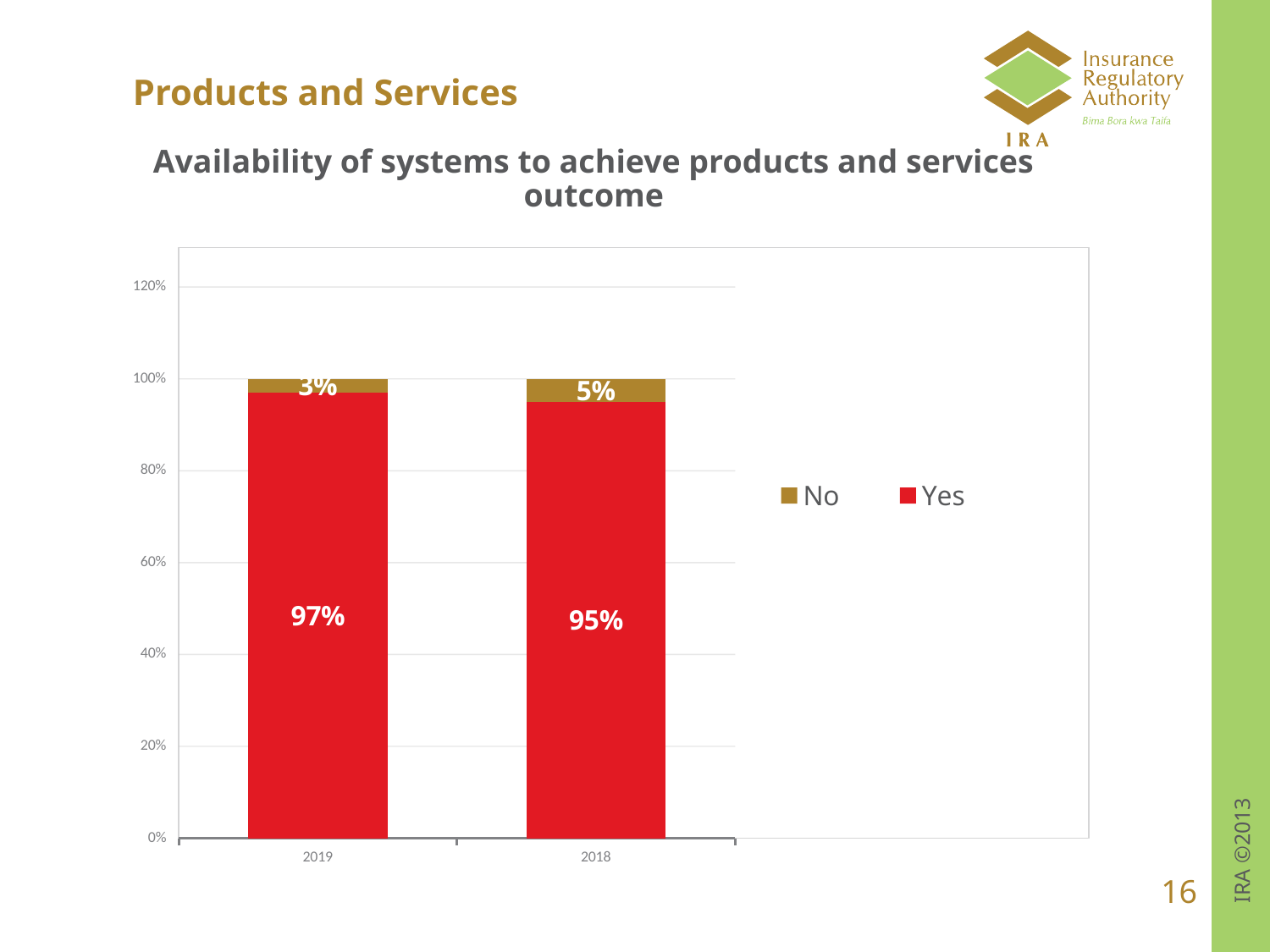
How many series does the legend list? 2 How many years are shown on the x axis? 2 What is the total of the stacked bar for 2019? 100% What is the value for Yes in 2018? 95% What is the value for No in 2018? 5% Which year has the lower No value? 2019 What is the difference between the Yes values for 2019 and 2018? 2% What is the value for Yes in 2019? 97% Is the No value for 2018 larger or smaller than the No value for 2019? larger What is the value for No in 2019? 3% Which year has the higher Yes value? 2019 What kind of chart is shown on the slide? Stacked bar chart